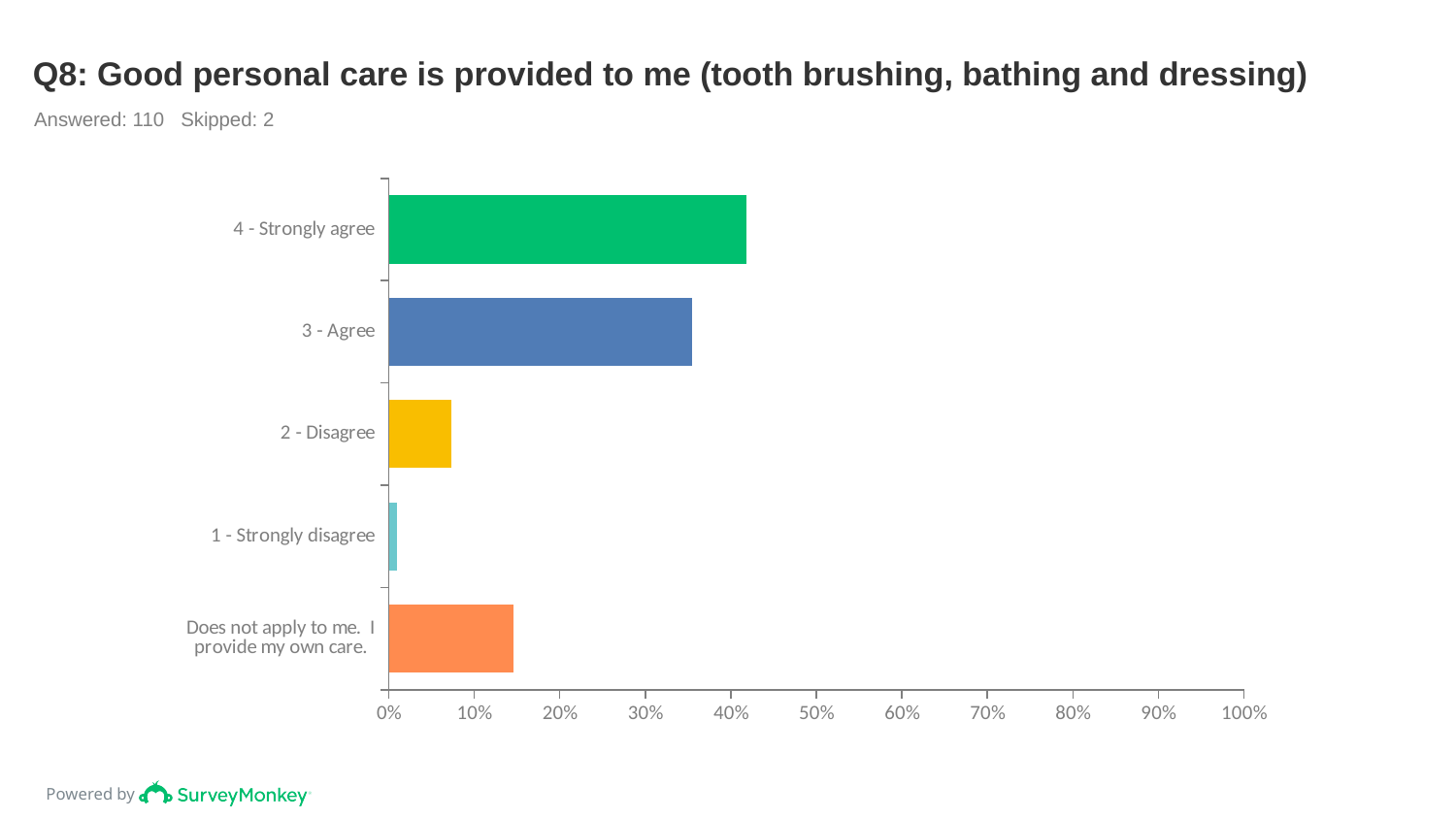
Is the value for 2 - Disagree greater or less than 10%? less Is the value for 'Does not apply to me. I provide my own care.' greater or less than 20%? less Which is larger, the value for 3 - Agree or the value for 4 - Strongly agree? 4 - Strongly agree What kind of chart is shown on the slide? bar chart What colour is the bar for 3 - Agree? blue Is the value for 4 - Strongly agree greater or less than 40%? greater How many categories are plotted in the chart? 5 How many respondents answered this question according to the slide? 110 Which category has the lowest value? 1 - Strongly disagree Which is larger, the value for 2 - Disagree or the value for 'Does not apply to me. I provide my own care.'? Does not apply to me. I provide my own care. Which category has the highest value? 4 - Strongly agree